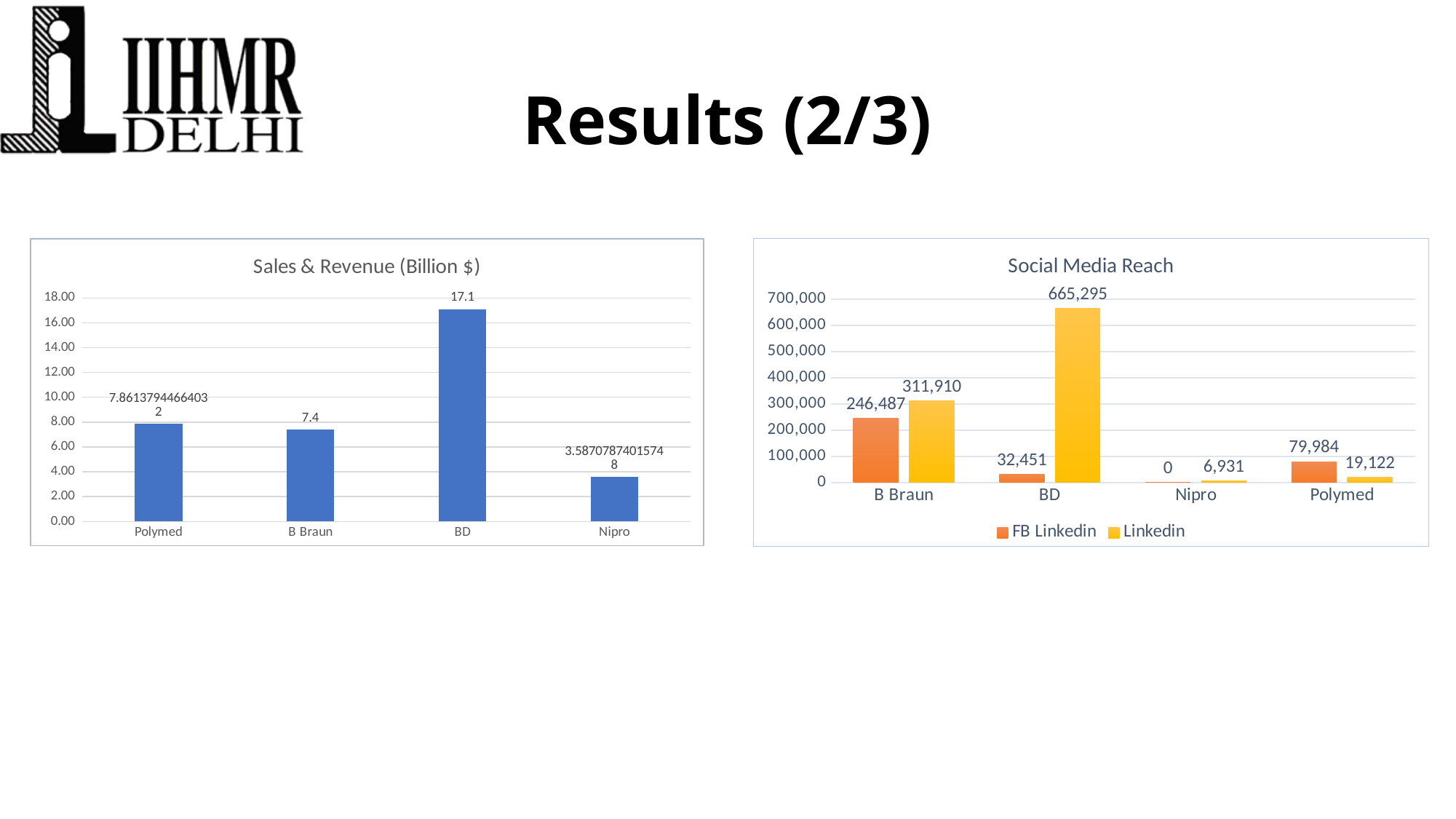
In the Sales & Revenue (Billion $) chart, what is the value for B Braun? 7.4 In the Sales & Revenue (Billion $) chart, which company has the lowest value? Nipro In the Social Media Reach chart, which is larger for B Braun: FB Linkedin or Linkedin? Linkedin In the Sales & Revenue (Billion $) chart, is the value for Nipro greater or less than 4.00? less In the Social Media Reach chart, what is the Linkedin value for BD? 665,295 In the Sales & Revenue (Billion $) chart, which company has the highest value? BD What type of chart is the Social Media Reach chart? Bar chart How many companies are shown in the Sales & Revenue (Billion $) chart? 4 In the Social Media Reach chart, what is the FB Linkedin value for B Braun? 246,487 How many series does the legend of the Social Media Reach chart list? 2 In the Sales & Revenue (Billion $) chart, what is the value for BD? 17.1 In the Social Media Reach chart, what is the difference between the Linkedin and FB Linkedin values for Polymed? 60,862